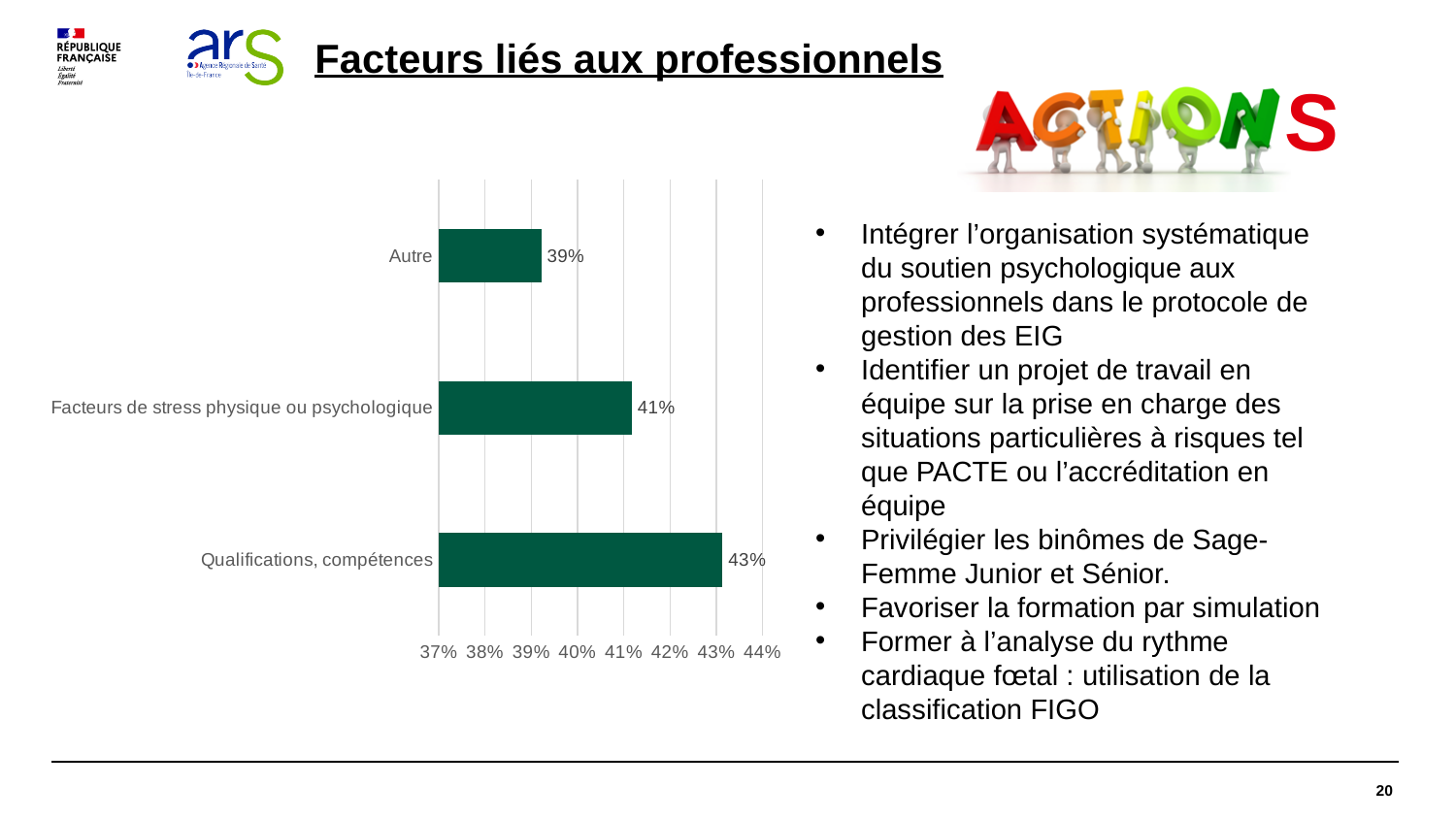
How many categories are shown in the chart? 3 What is the value for Facteurs de stress physique ou psychologique? 41% What is the value for Qualifications, compétences? 43% Which category has the lowest value? Autre What colour are the bars in the chart? dark green What kind of chart is shown on the slide? bar chart Which category has the highest value? Qualifications, compétences What is the difference between the values for Facteurs de stress physique ou psychologique and Autre? 2% Is the value for Qualifications, compétences greater or less than 40%? greater What is the value for Autre? 39% Which is larger: the value for Facteurs de stress physique ou psychologique or the value for Autre? Facteurs de stress physique ou psychologique What is the difference between the values for Qualifications, compétences and Autre? 4%